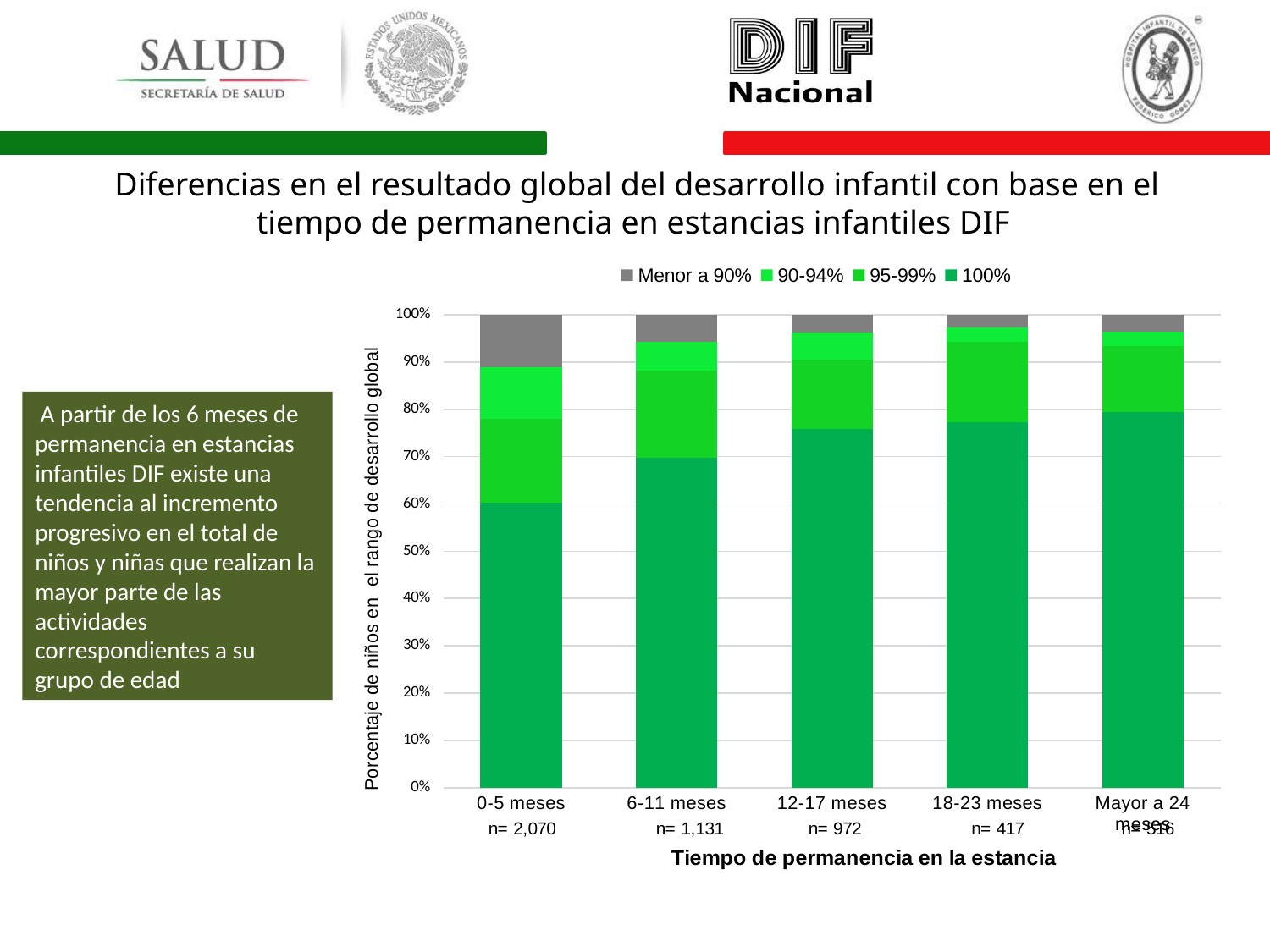
How many series does the legend list? 4 What is the title of the x axis? Tiempo de permanencia en la estancia Which category has the largest share of children in the 100% range? Mayor a 24 meses Is the share of children in the 100% range for 12-17 meses greater or less than 70%? greater Which category has the smallest share of children in the 100% range? 0-5 meses What sample size (n) is shown for the 0-5 meses category? n= 2,070 Which has a larger 'Menor a 90%' segment, 0-5 meses or 6-11 meses? 0-5 meses Does the share of children in the 100% range rise or fall as time of stay increases along the x axis? Rises How many time-of-stay categories are shown on the x axis? 5 What is the total height of each stacked bar? 100% What kind of chart is shown on the slide? Stacked bar chart Is the share of children in the 100% range for Mayor a 24 meses greater or less than 70%? greater